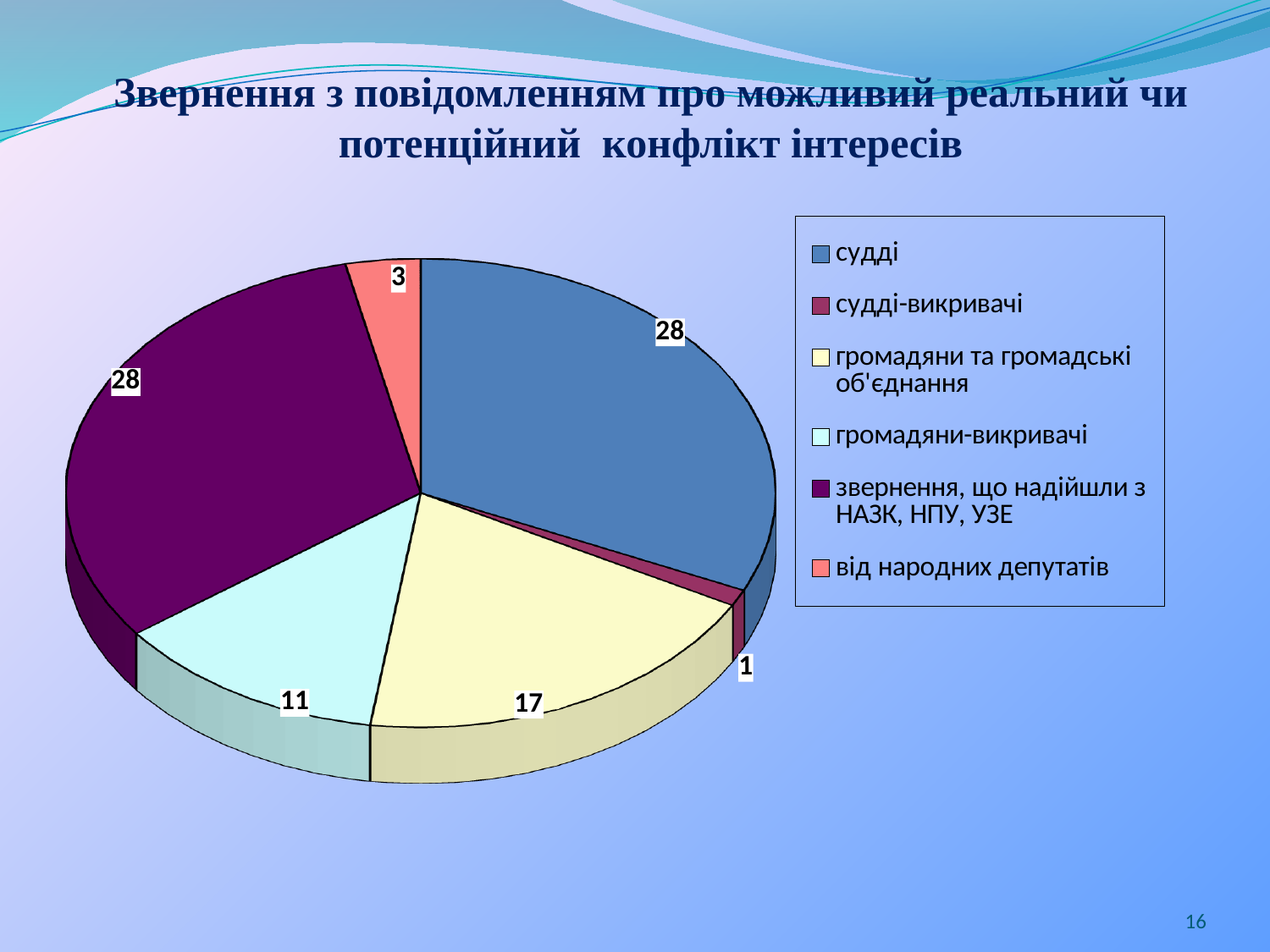
Which category has the smallest slice? судді-викривачі What type of chart is shown on the slide? Pie chart What is the value for the "судді" slice? 28 What is the value for the "від народних депутатів" slice? 3 What is the difference between the "громадяни та громадські об'єднання" value and the "громадяни-викривачі" value? 6 Which is larger: the value for "судді" or the value for "громадяни та громадські об'єднання"? судді What is the value for the "громадяни та громадські об'єднання" slice? 17 What share of the total does the "громадяни-викривачі" slice represent? 12.5% What colour is the "звернення, що надійшли з НАЗК, НПУ, УЗЕ" slice? Purple What is the value for the "судді-викривачі" slice? 1 What is the value for the "громадяни-викривачі" slice? 11 How many categories does the pie chart have? 6